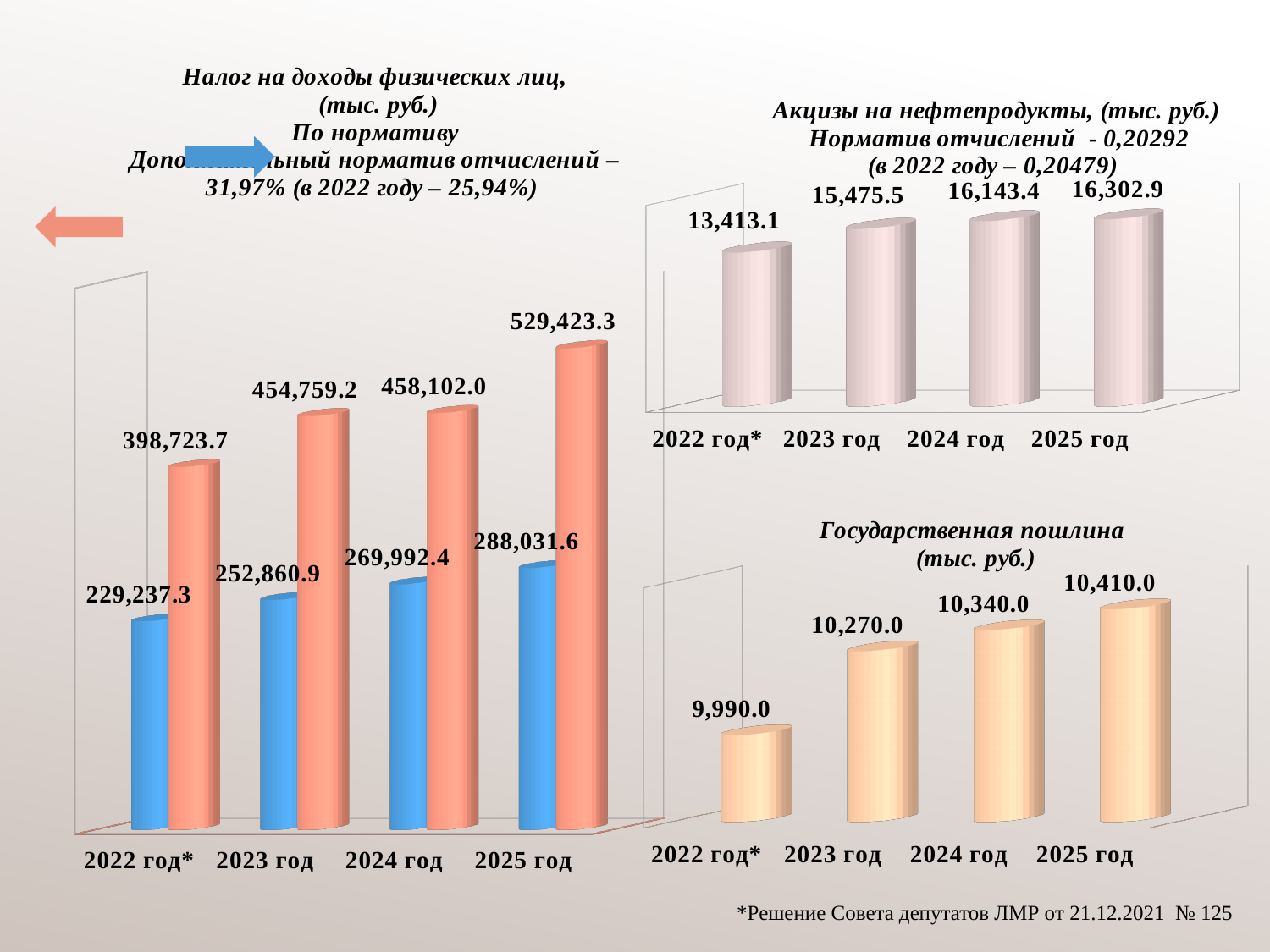
In the 'Налог на доходы физических лиц' chart, which is larger: the orange bar for 2023 год or the orange bar for 2024 год? 2024 год In the 'Акцизы на нефтепродукты' chart, what is the value for 2023 год? 15,475.5 In the 'Акцизы на нефтепродукты' chart, which year has the lowest value? 2022 год* In the 'Акцизы на нефтепродукты' chart, what is the difference between the 2025 год and 2022 год* values? 2,889.8 In the 'Государственная пошлина' chart, what is the value for 2024 год? 10,340.0 In the 'Государственная пошлина' chart, do the values rise or fall from 2022 to 2025? rise In the 'Государственная пошлина' chart, which year has the highest value? 2025 год In the 'Налог на доходы физических лиц' chart, what is the value of the blue bar for 2023 год? 252,860.9 In the 'Налог на доходы физических лиц' chart, what is the value of the orange bar for 2025 год? 529,423.3 What type of chart is the 'Акцизы на нефтепродукты' chart? bar chart In the 'Налог на доходы физических лиц' chart, what is the difference between the orange and blue bars for 2022 год*? 169,486.4 In the 'Государственная пошлина' chart, how many years are plotted? 4